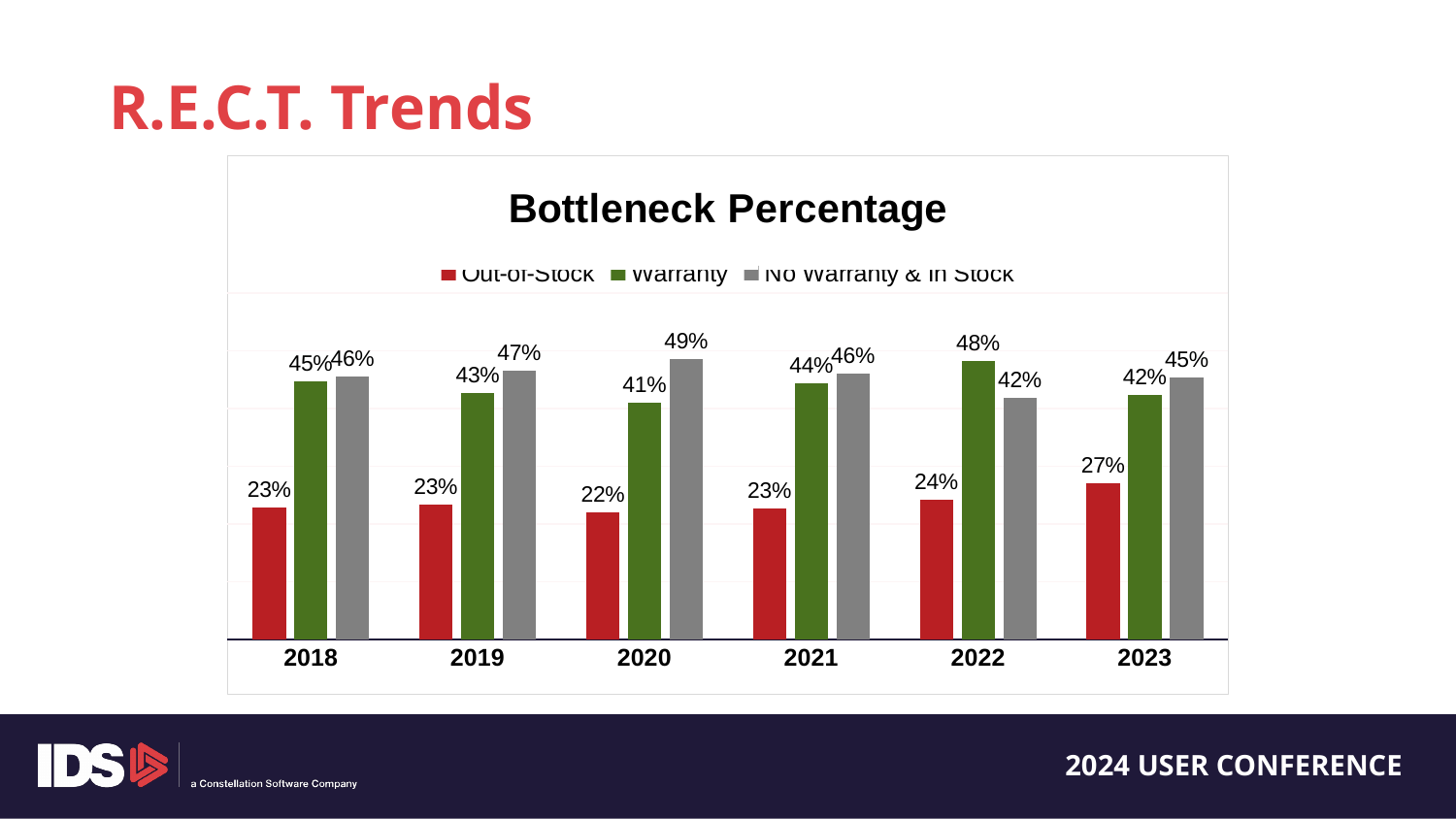
What kind of chart is shown on the slide? Bar chart What is the Out-of-Stock value for 2023? 27% What is the difference between the Warranty and Out-of-Stock values in 2022? 24% In which year is the Out-of-Stock value lowest? 2020 Which is larger in 2022, the Warranty value or the No Warranty & In Stock value? Warranty What is the No Warranty & In Stock value for 2019? 47% How many years are shown on the x axis? 6 How many series does the legend list? 3 What is the title of the chart? Bottleneck Percentage In which year is the Warranty value highest? 2022 In which year is the No Warranty & In Stock value highest? 2020 What is the Warranty value for 2020? 41%